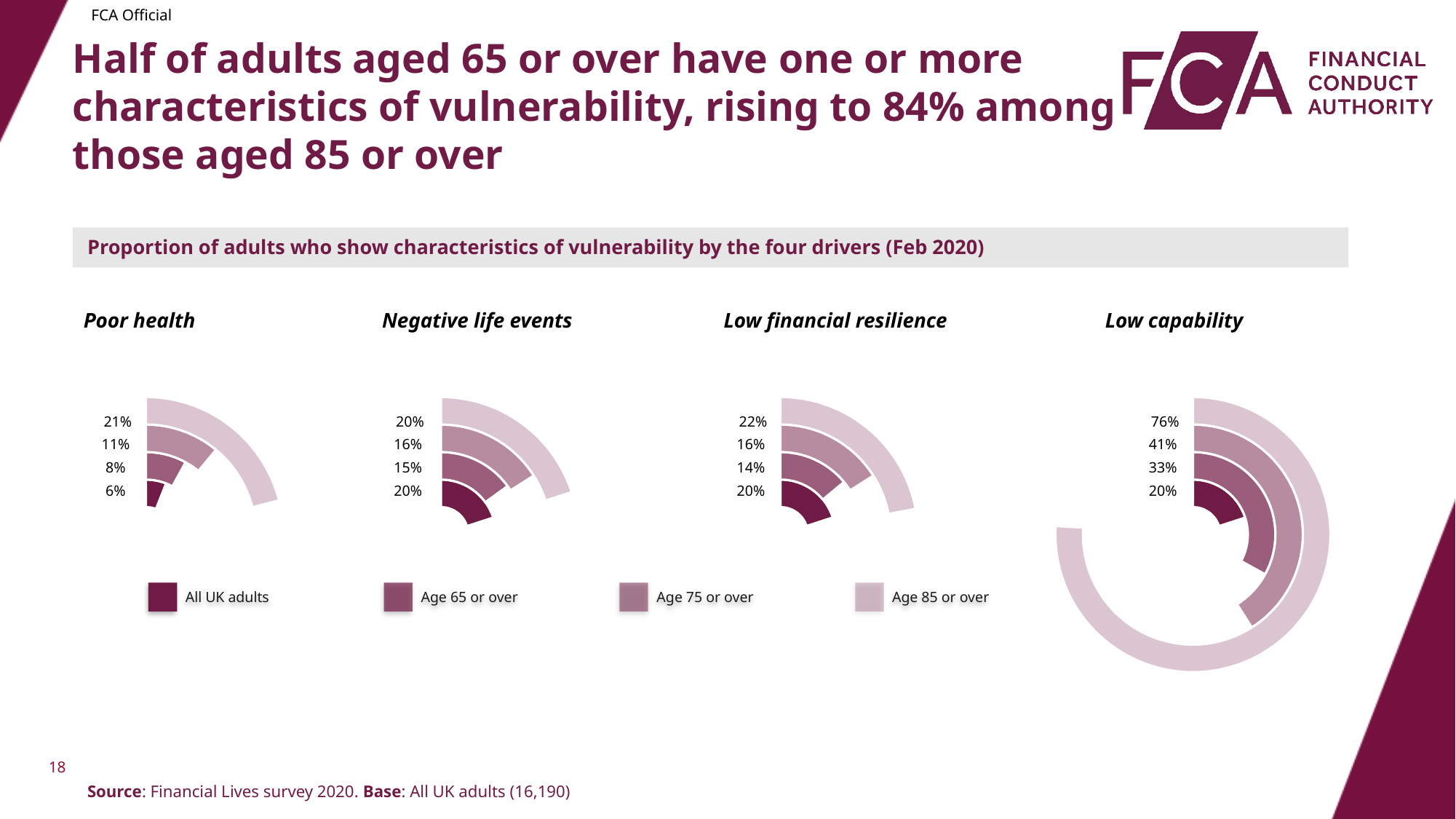
In the Poor health chart, what is the value for Age 85 or over? 21% In the Low capability chart, what is the value for All UK adults? 20% In the Poor health chart, which group has the lowest value? All UK adults Which legend entry is shown in the darkest colour? All UK adults In the Low capability chart, which age group has the highest value? Age 85 or over In the Low capability chart, what is the difference between the values for Age 85 or over and Age 75 or over? 35% In the Low financial resilience chart, what is the value for Age 75 or over? 16% How many charts are shown on the slide? 4 In the Negative life events chart, what is the value for Age 65 or over? 15% In the Poor health chart, what is the difference between the values for Age 85 or over and All UK adults? 15% In the Low financial resilience chart, which is larger: the value for All UK adults or the value for Age 65 or over? All UK adults How many series does the legend list? 4